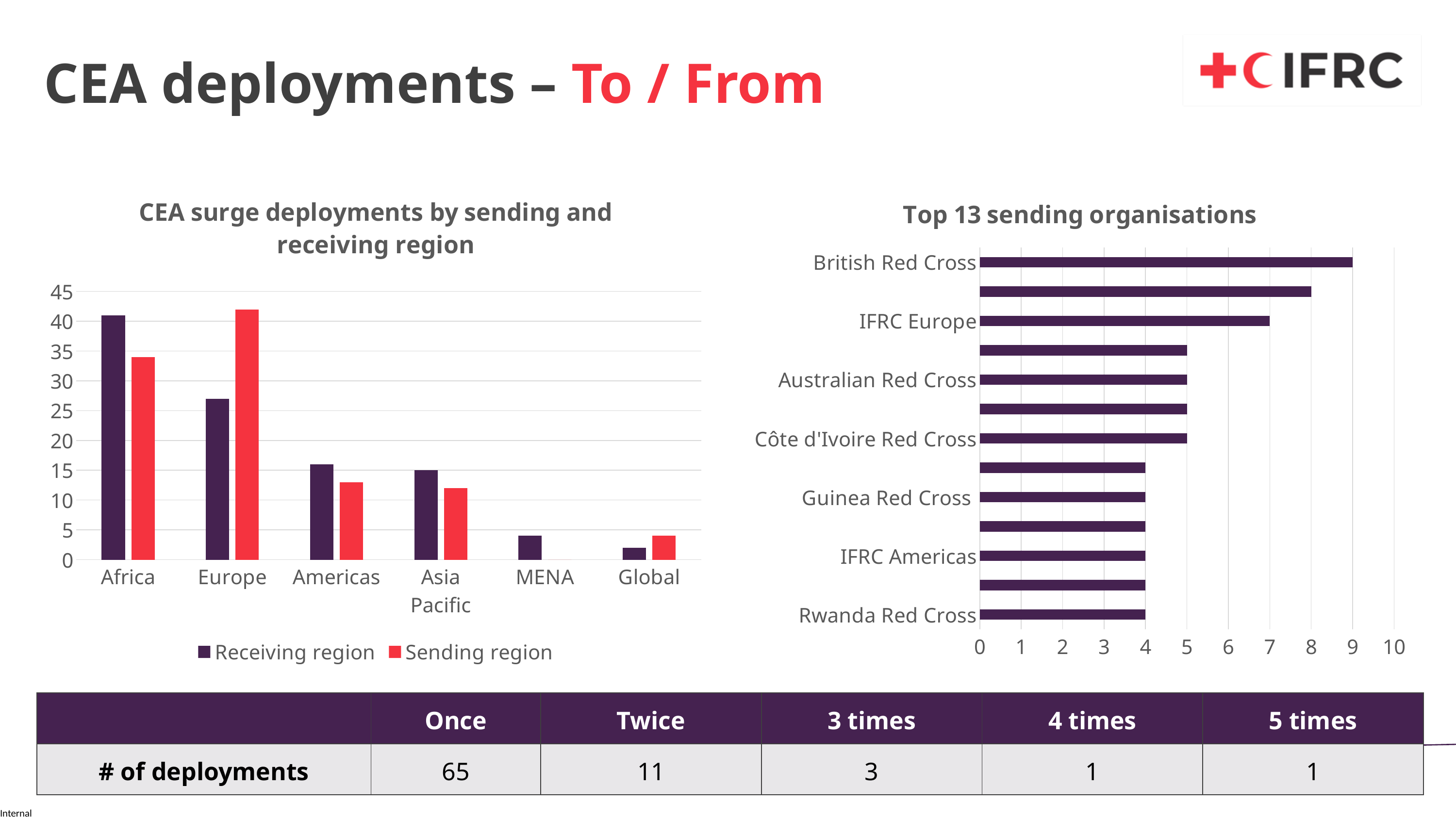
In the 'CEA surge deployments by sending and receiving region' chart, is the Receiving region value for MENA greater or less than 10? less In the 'CEA surge deployments by sending and receiving region' chart, is the Receiving region value for Africa greater or less than 35? greater In the 'Top 13 sending organisations' chart, which organisation has the highest value? British Red Cross In the 'CEA surge deployments by sending and receiving region' chart, which region has the highest Sending region value? Europe In the 'Top 13 sending organisations' chart, what is the difference between the values for British Red Cross and Rwanda Red Cross? 5 In the 'Top 13 sending organisations' chart, what is the value for British Red Cross? 9 In the 'Top 13 sending organisations' chart, what is the value for IFRC Europe? 7 In the 'CEA surge deployments by sending and receiving region' chart, which region has the highest Receiving region value? Africa How many series does the legend of the 'CEA surge deployments by sending and receiving region' chart list? 2 How many regions are shown on the x axis of the 'CEA surge deployments by sending and receiving region' chart? 6 In the 'CEA surge deployments by sending and receiving region' chart, for Europe, is the Receiving region or the Sending region value larger? Sending region What kind of chart is the 'CEA surge deployments by sending and receiving region' chart? bar chart